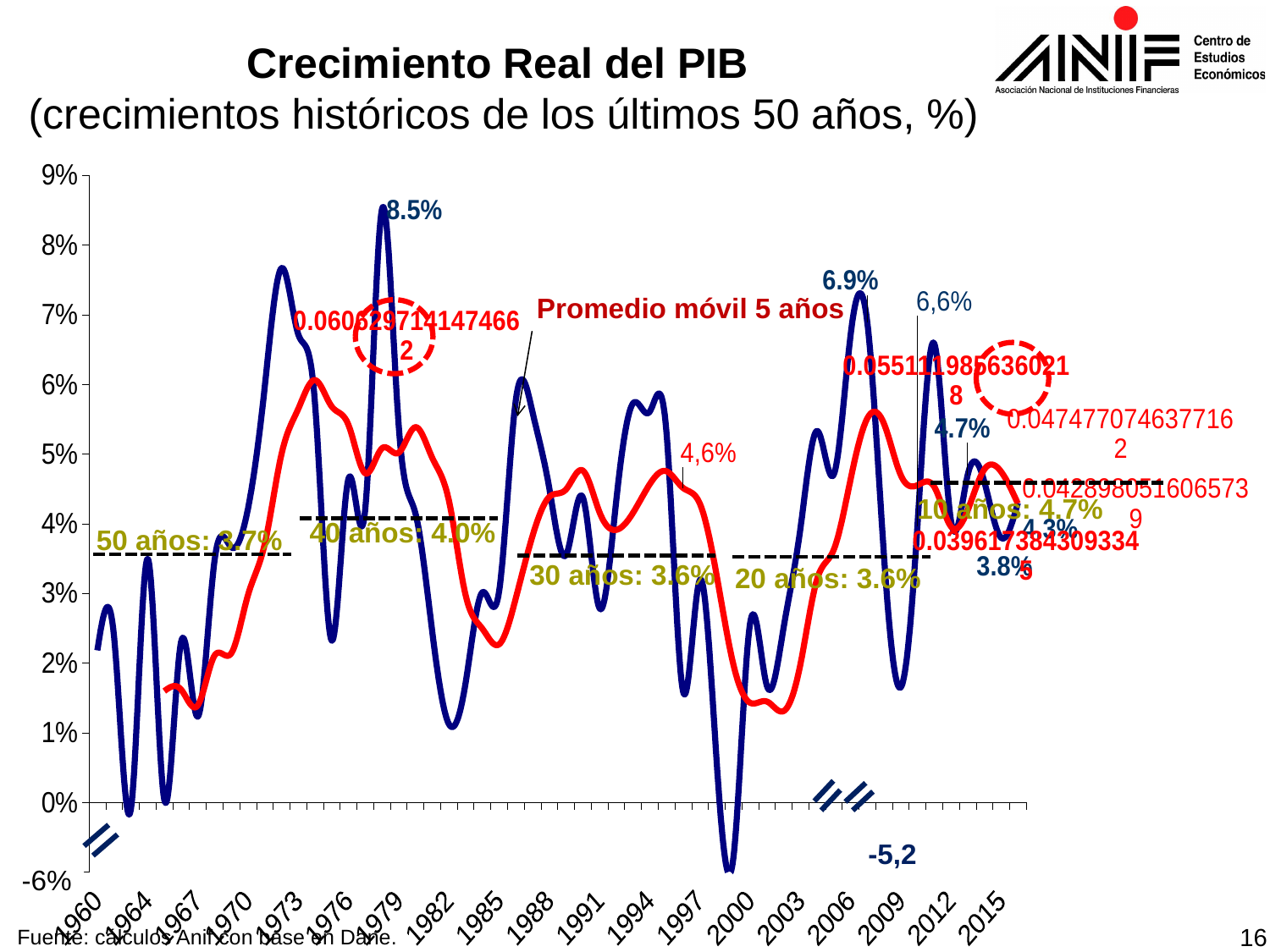
What is the average growth shown for the 40-year period (40 años)? 4.0% What is the lowest labelled growth value on the chart? -5,2 What is the average growth shown for the 30-year period (30 años)? 3.6% What is the average growth shown for the 10-year period (10 años)? 4.7% Is the 20-year average (20 años) greater or less than 4%? less What is the difference between the 8.5% peak and the 6.9% peak labelled on the chart? 1.6 percentage points What is the title of the chart? Crecimiento Real del PIB What does the red line on the chart represent? Promedio móvil 5 años Which period average is larger, 40 años or 30 años? 40 años What kind of chart is shown on the slide? line chart What is the highest labelled growth value on the chart? 8.5% What is the average growth shown for the 50-year period (50 años)? 3.7%